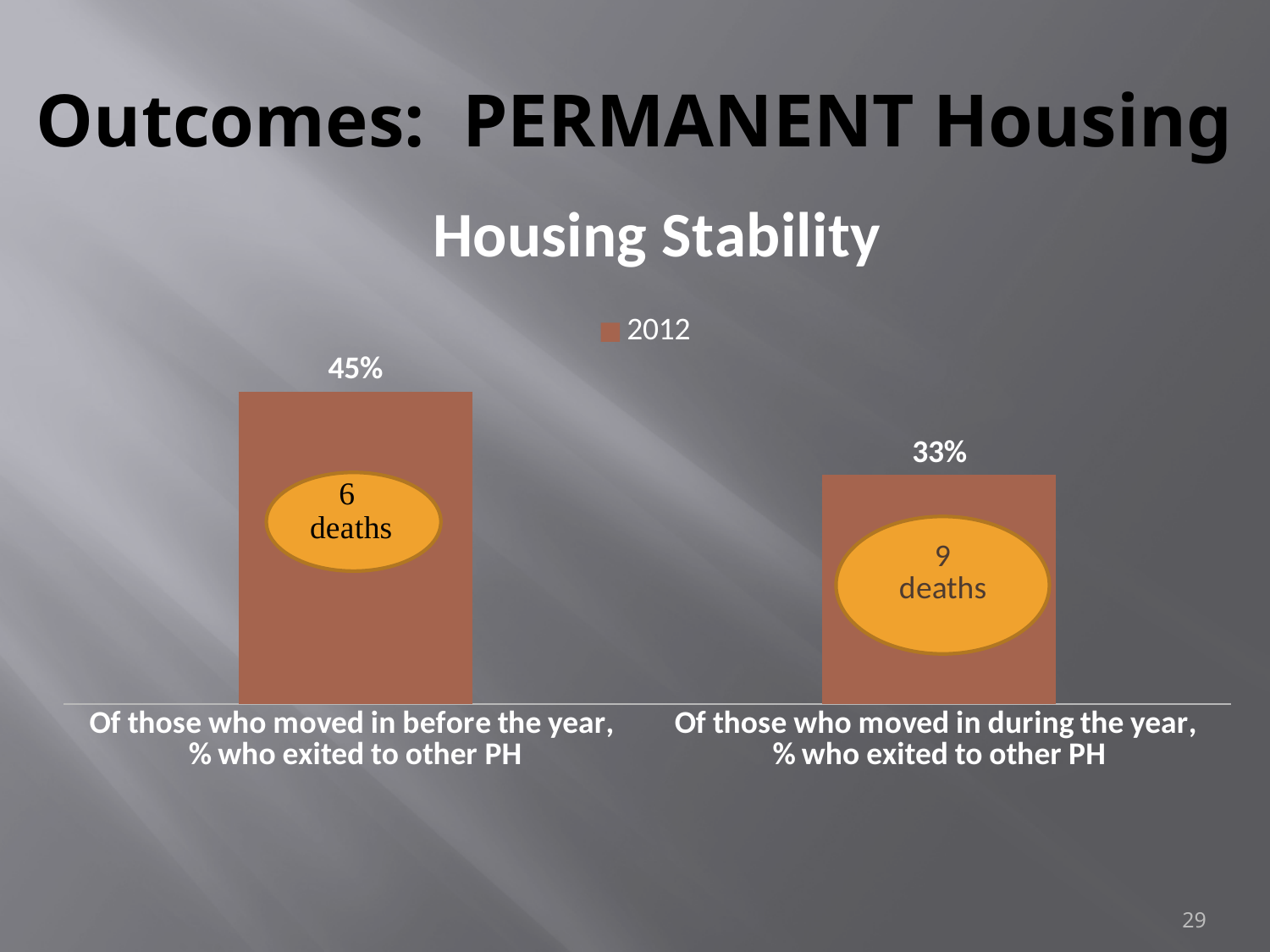
What is the difference between the value for those who moved in before the year and those who moved in during the year? 12% What series name is shown in the legend? 2012 Which category has the highest value? Of those who moved in before the year, % who exited to other PH How many series does the legend list? 1 Which category has the lowest value? Of those who moved in during the year, % who exited to other PH Do the values rise or fall from the left category to the right category? Fall What kind of chart is shown on the slide? Bar chart What is the value for 'Of those who moved in during the year, % who exited to other PH'? 33% Which is larger: the value for those who moved in before the year or those who moved in during the year? Of those who moved in before the year, % who exited to other PH What is the value for 'Of those who moved in before the year, % who exited to other PH'? 45% How many categories are shown in the chart? 2 What is the title of the chart? Housing Stability